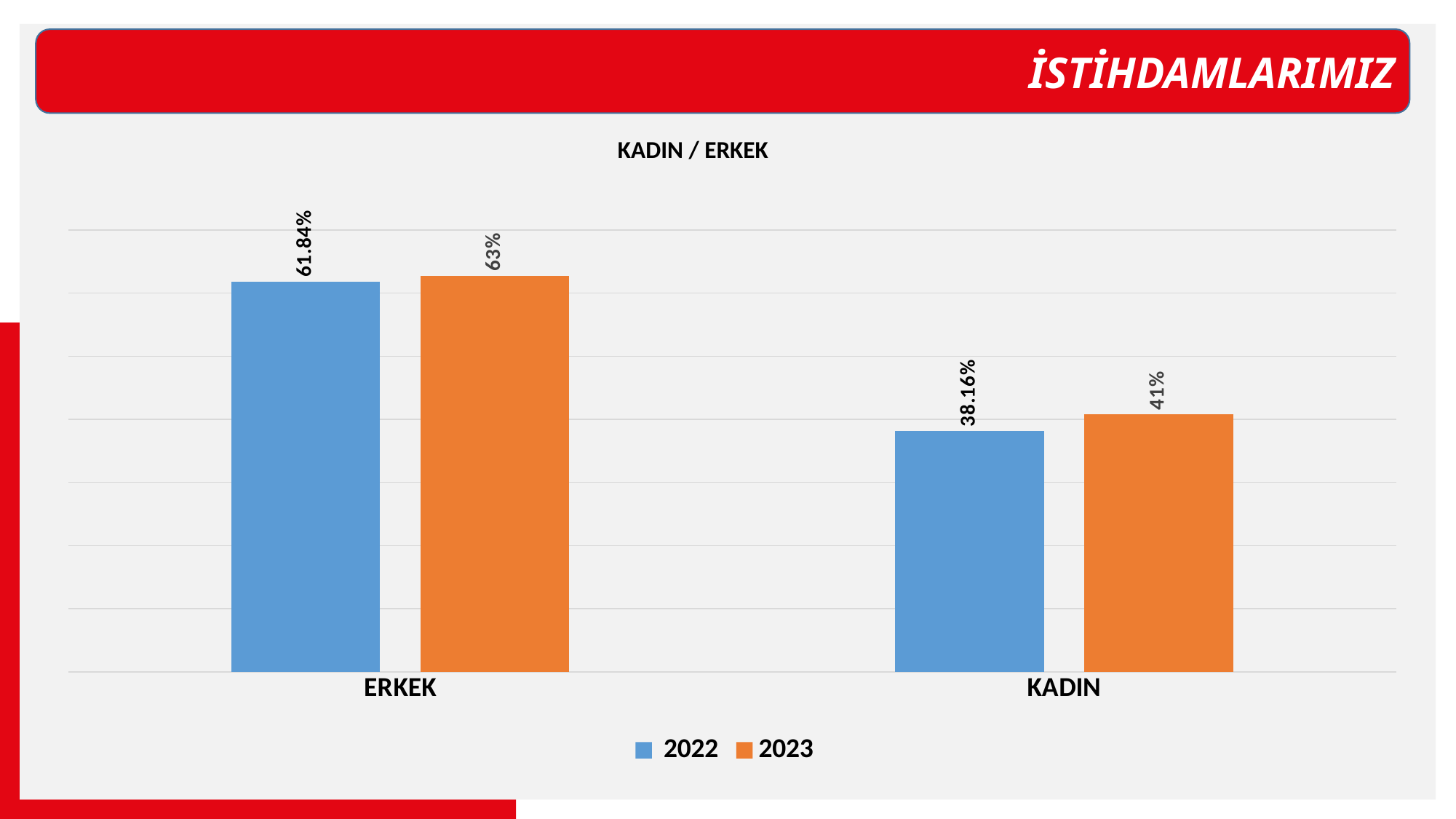
What is the value for KADIN in the 2022 series? 38.16% What is the value for ERKEK in the 2022 series? 61.84% Which is larger for ERKEK: the 2022 value or the 2023 value? 2023 What is the value for ERKEK in the 2023 series? 63% What kind of chart is shown on the slide? Bar chart What is the difference between the 2022 values for ERKEK and KADIN? 23.68 percentage points Which category has the highest value in the 2023 series? ERKEK What is the value for KADIN in the 2023 series? 41% How many series does the legend list? 2 What is the difference between the 2023 and 2022 values for KADIN? 2.84 percentage points How many categories are shown on the x axis? 2 Which category has the lowest value in the 2022 series? KADIN